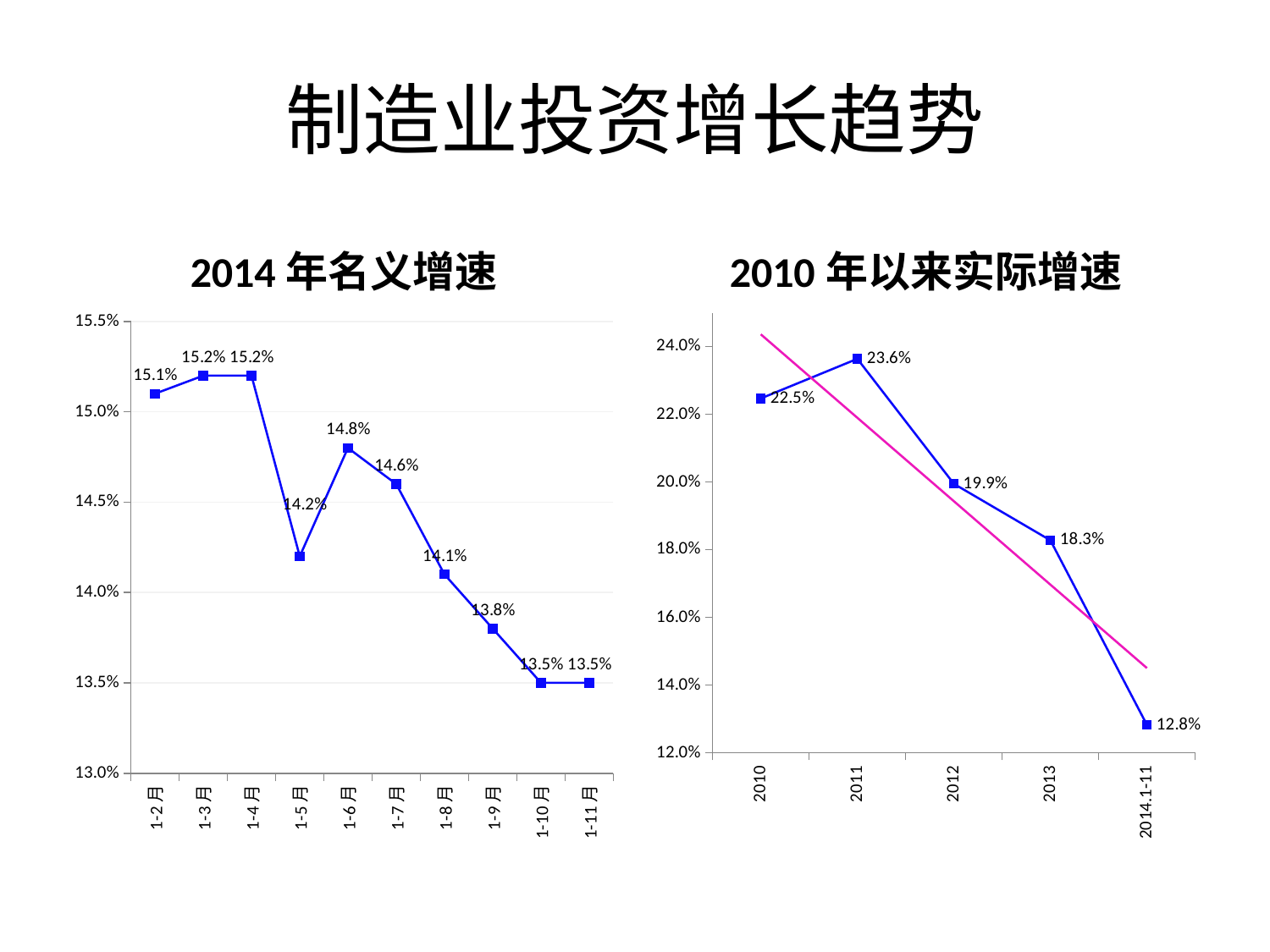
In the left chart (2014 年名义增速), what is the value for 1-5 月? 14.2% In the left chart (2014 年名义增速), is the value for 1-7 月 greater or less than 14.5%? greater In the right chart (2010 年以来实际增速), which is larger, the value for 2010 or the value for 2013? 2010 What kind of chart is the right chart (2010 年以来实际增速)? line chart In the right chart (2010 年以来实际增速), which year has the highest value? 2011 In the right chart (2010 年以来实际增速), what is the value for 2012? 19.9% In the left chart (2014 年名义增速), what is the difference between the values for 1-2 月 and 1-11 月? 1.6% In the right chart (2010 年以来实际增速), do the values generally rise or fall from 2011 to 2014.1-11? fall In the right chart (2010 年以来实际增速), what is the difference between the values for 2011 and 2014.1-11? 10.8% In the left chart (2014 年名义增速), what is the value for 1-6 月? 14.8% In the left chart (2014 年名义增速), how many data points are plotted? 10 In the left chart (2014 年名义增速), which period has the lowest value? 1-10 月 and 1-11 月 (13.5%)